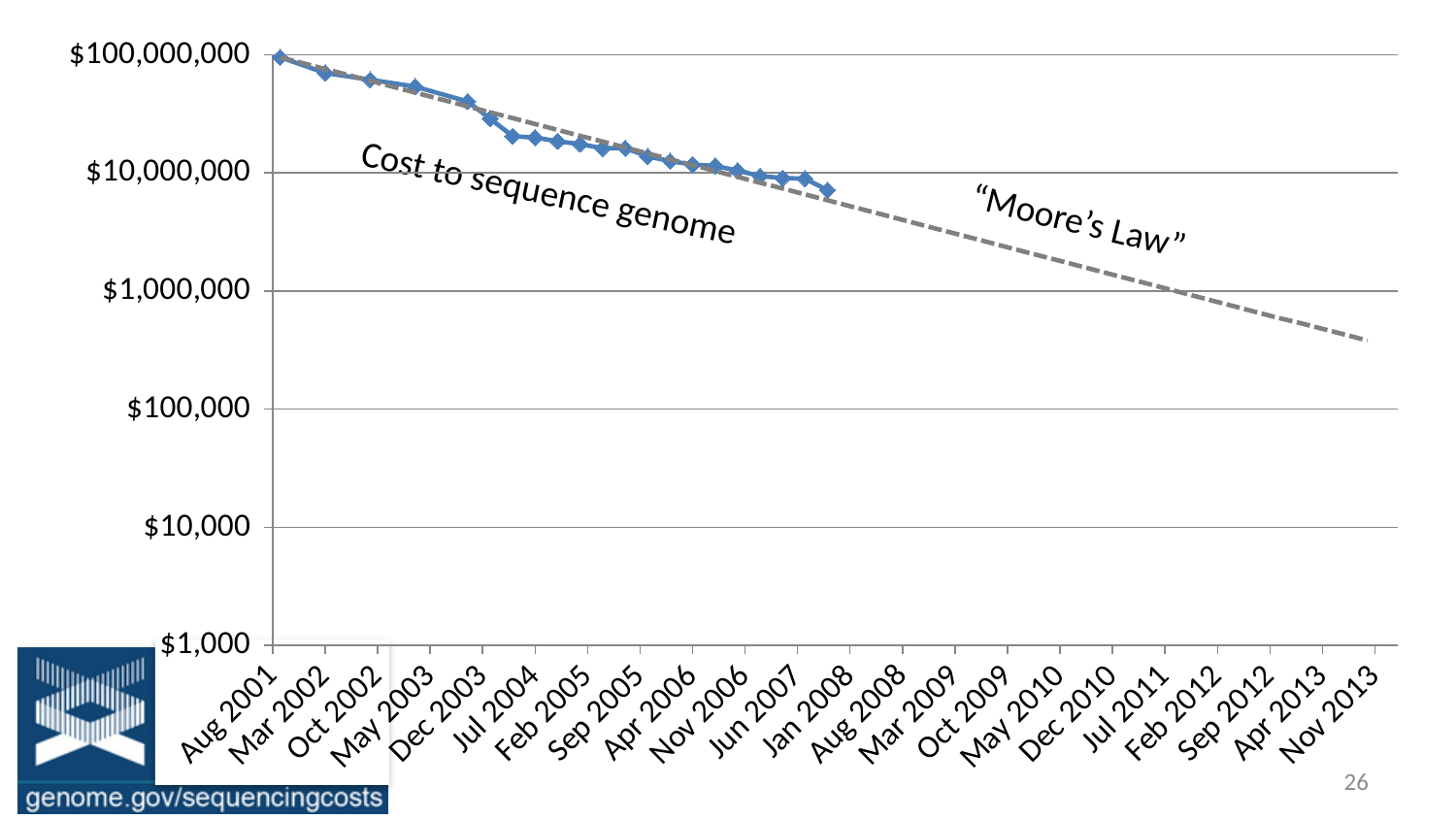
What source is cited in the bottom-left corner of the slide? genome.gov/sequencingcosts Does the cost to sequence a genome rise or fall over time along the x axis? fall What kind of chart is shown on the slide? line chart Which series reaches a lower value on the chart, Cost to sequence genome or "Moore's Law"? "Moore's Law" At which x-axis date is the cost to sequence genome highest? Aug 2001 How many date labels are shown on the x axis? 22 What are the two series labelled on the chart? Cost to sequence genome and "Moore's Law" Is the cost to sequence genome at Jan 2008 greater or less than $10,000,000? less Is the "Moore's Law" line at Nov 2013 greater or less than $1,000,000? less How many series are plotted on the chart? 2 Is the cost to sequence genome at Dec 2003 greater or less than $10,000,000? greater